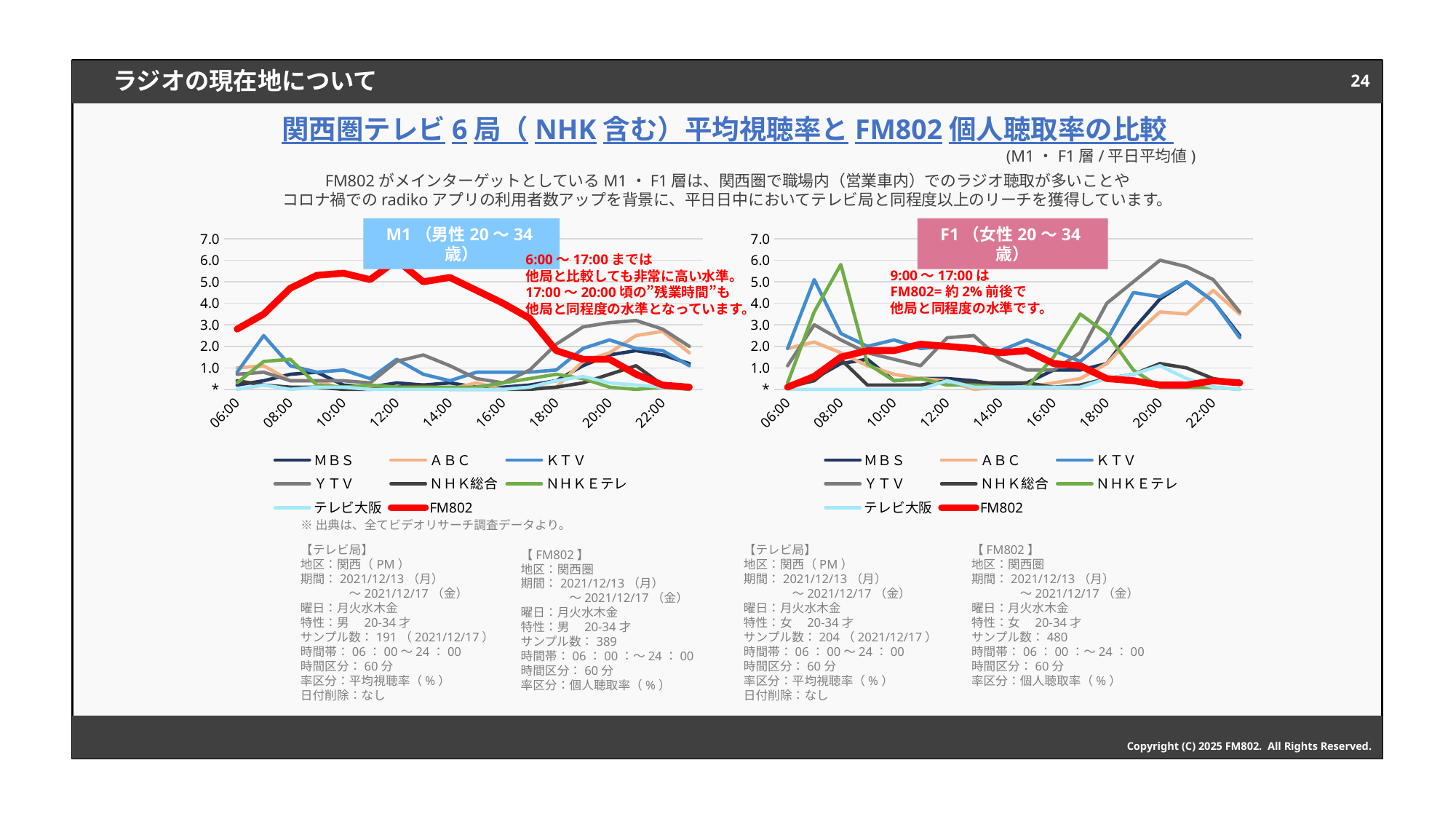
In the left chart (M1), is the value for FM802 at 12:00 greater or less than 5.0? greater In the left chart (M1), is the value for FM802 at 22:00 greater or less than 1.0? less In the left chart (M1), which series has the highest value at 12:00? FM802 In the left chart (M1), does the FM802 line rise or fall from 12:00 to 22:00? fall In the right chart (F1), is the value for FM802 at 22:00 greater or less than 1.0? less What colour is the FM802 line in the right chart (F1)? red What kind of chart is the left chart (M1)? line chart In the left chart (M1), which is larger at 10:00, FM802 or KTV? FM802 How many time labels are shown on the x axis of the left chart (M1)? 9 How many series does the legend of the right chart (F1) list? 8 In the right chart (F1), which series has the highest value at 08:00? NHKEテレ